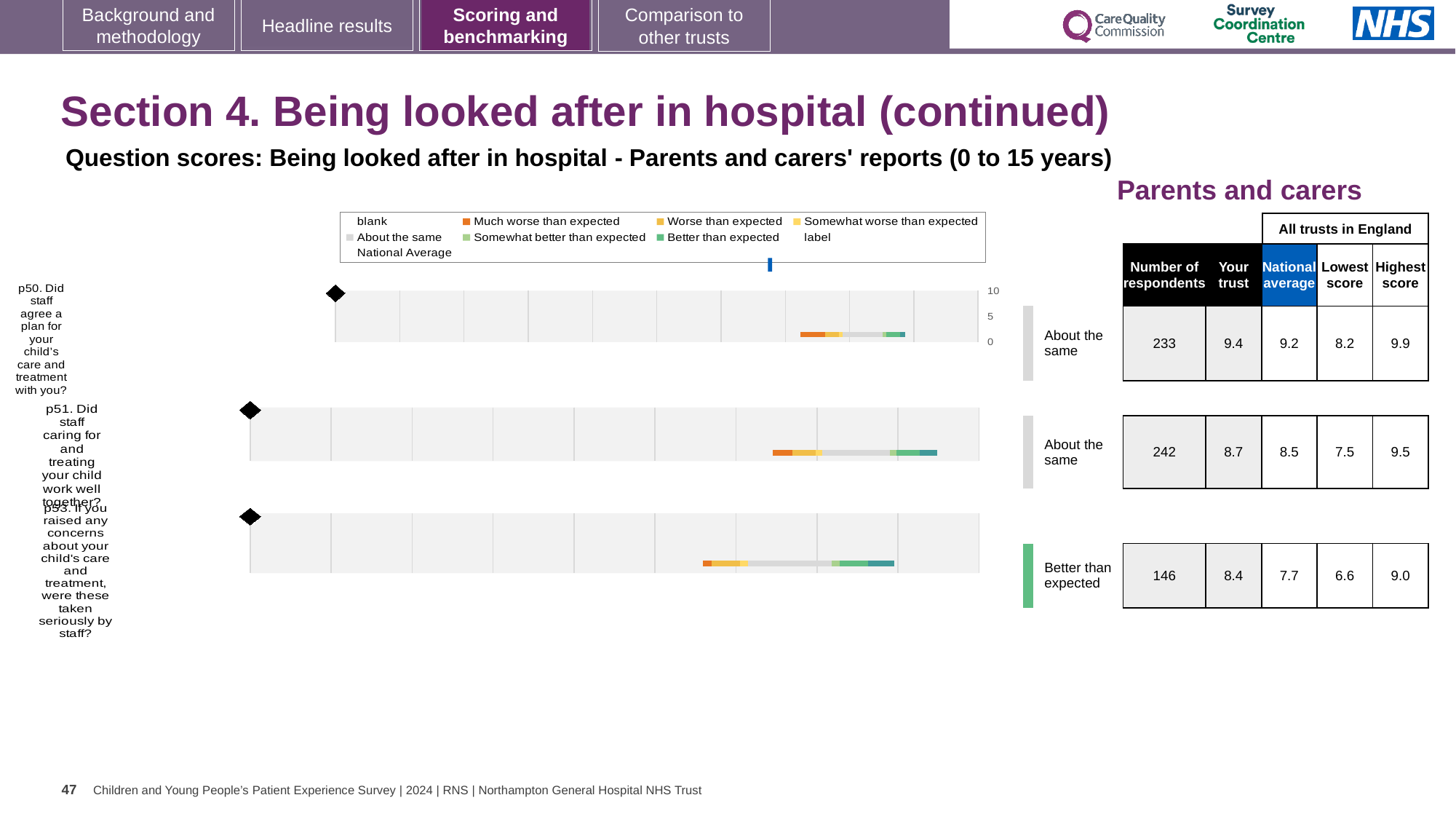
For the p53 chart, what is the highest score among all trusts in England? 9.0 Which of the three questions (p50, p51, p53) has the highest 'Your trust' score? p50 How many question charts (p50, p51, p53) are shown on the slide? 3 For the p50 chart (Did staff agree a plan for your child's care and treatment with you?), what is the 'Your trust' score shown in the table? 9.4 For the p51 chart (Did staff caring for and treating your child work well together?), what is the national average score shown in the table? 8.5 What is the highest value shown on the vertical axis of the p50 chart? 10 For the p53 chart (If you raised any concerns about your child's care and treatment, were these taken seriously by staff?), what is the number of respondents? 146 For the p53 chart, what is the difference between the 'Your trust' score and the national average? 0.7 What kind of chart is used for each question (p50, p51, p53) on the slide? bar chart Which of the three questions (p50, p51, p53) has the lowest national average score? p53 Which question (p50, p51 or p53) is rated 'Better than expected' on the slide? p53 For the p51 chart, which is larger: the 'Your trust' score or the national average? Your trust